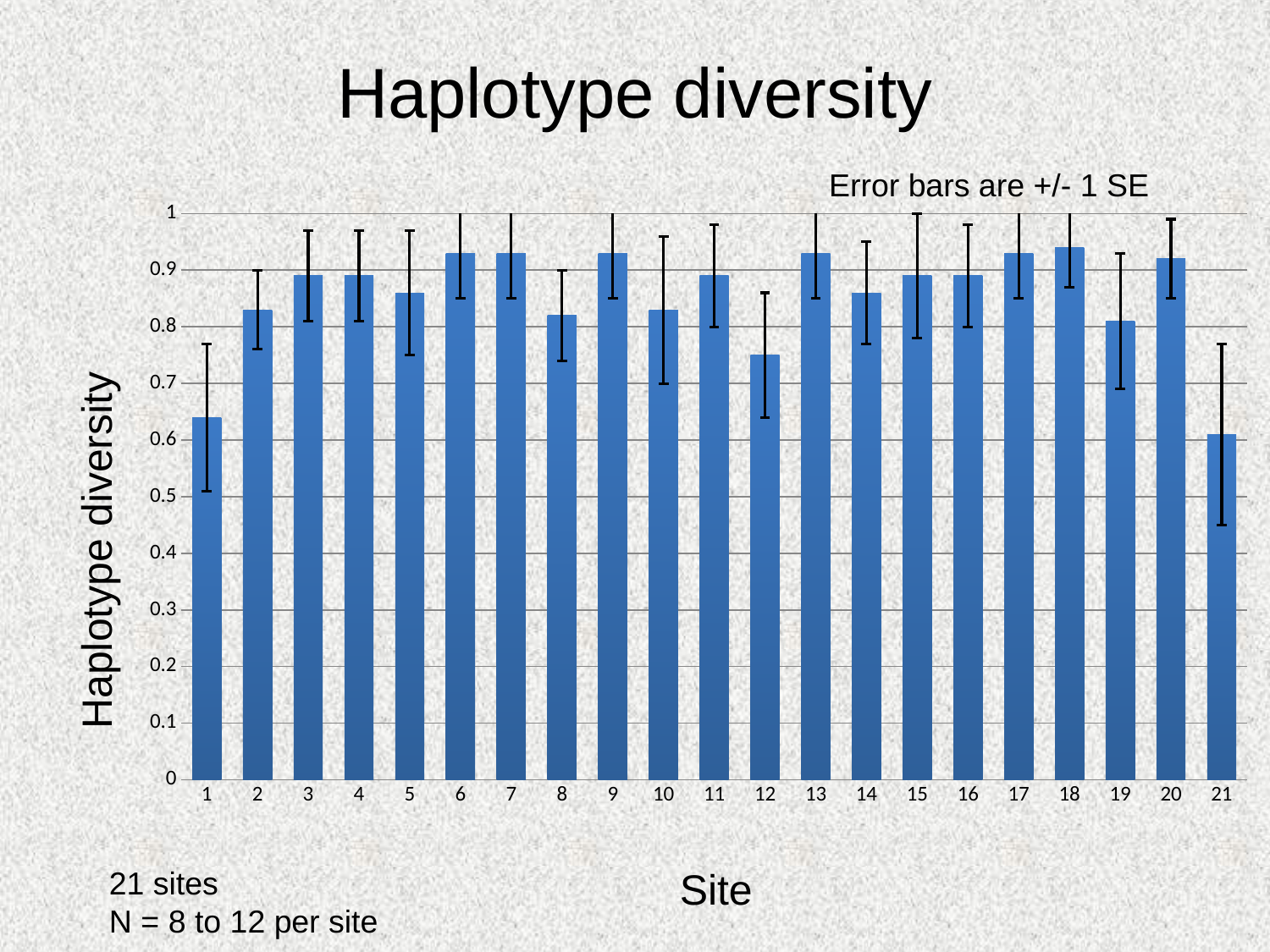
Is the haplotype diversity for site 6 greater or less than 0.9? greater Is the haplotype diversity for site 5 greater or less than 0.9? less Which site has the higher haplotype diversity, site 6 or site 12? site 6 Is the haplotype diversity for site 21 greater or less than 0.5? greater What kind of chart is shown on the slide? bar chart Which site has the higher haplotype diversity, site 1 or site 2? site 2 How many sites are plotted along the x axis? 21 What is the title of the chart? Haplotype diversity According to the note on the chart, what do the error bars represent? +/- 1 SE